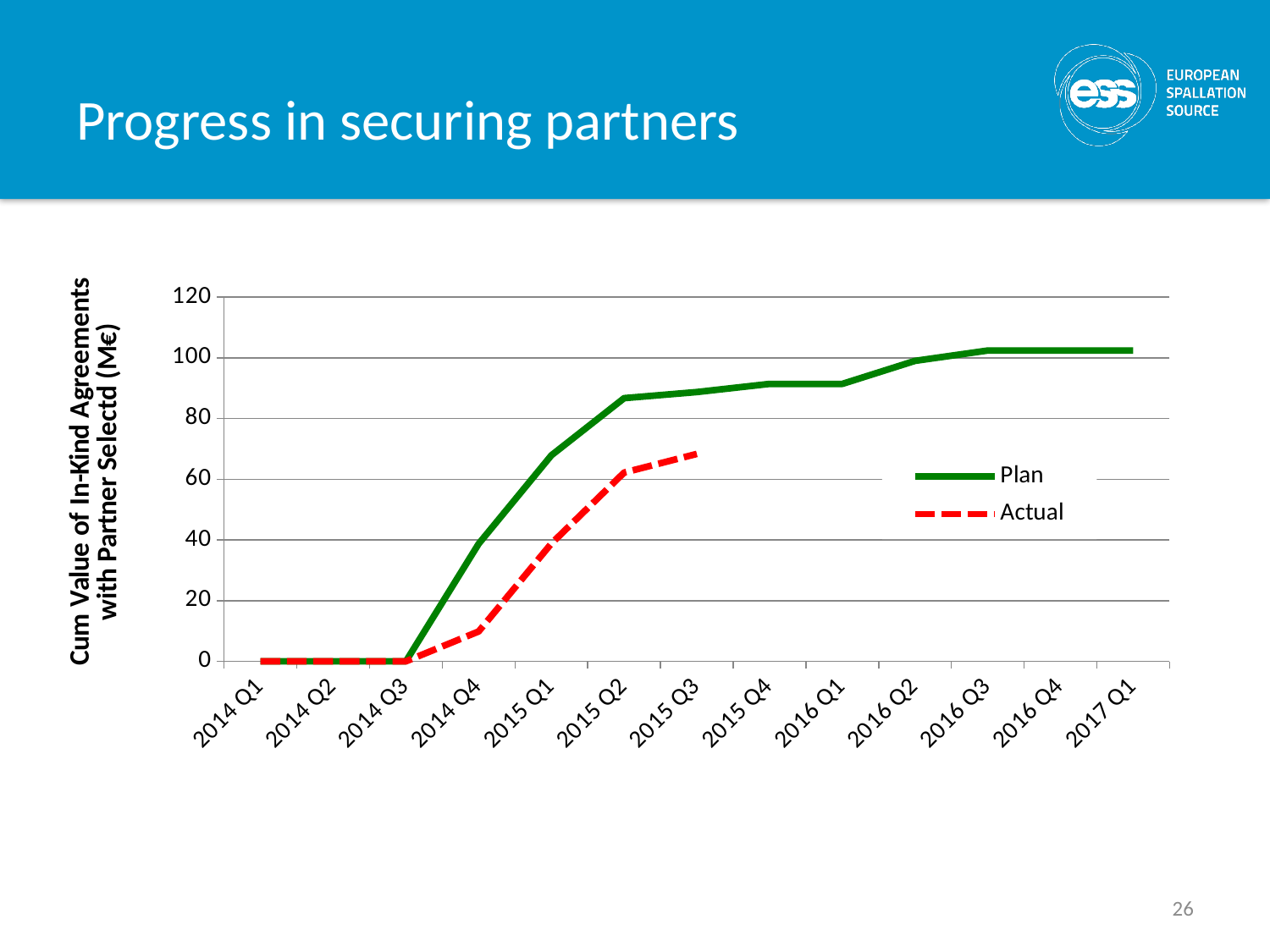
Is the Plan value for 2015 Q2 greater or less than 80? greater What kind of chart is shown on the slide? line chart Is the Plan value for 2016 Q1 greater or less than 100? less What is the Plan value for 2014 Q1? 0 Is the Actual value for 2015 Q3 greater or less than 60? greater How many series does the legend list? 2 How many quarters are shown along the x axis? 13 What is the title of the y axis? Cum Value of In-Kind Agreements with Partner Selectd (M€) At 2015 Q2, which series has the larger value, Plan or Actual? Plan What is the Actual value for 2014 Q3? 0 Does the Plan line rise or fall from 2014 Q3 to 2016 Q3? rise